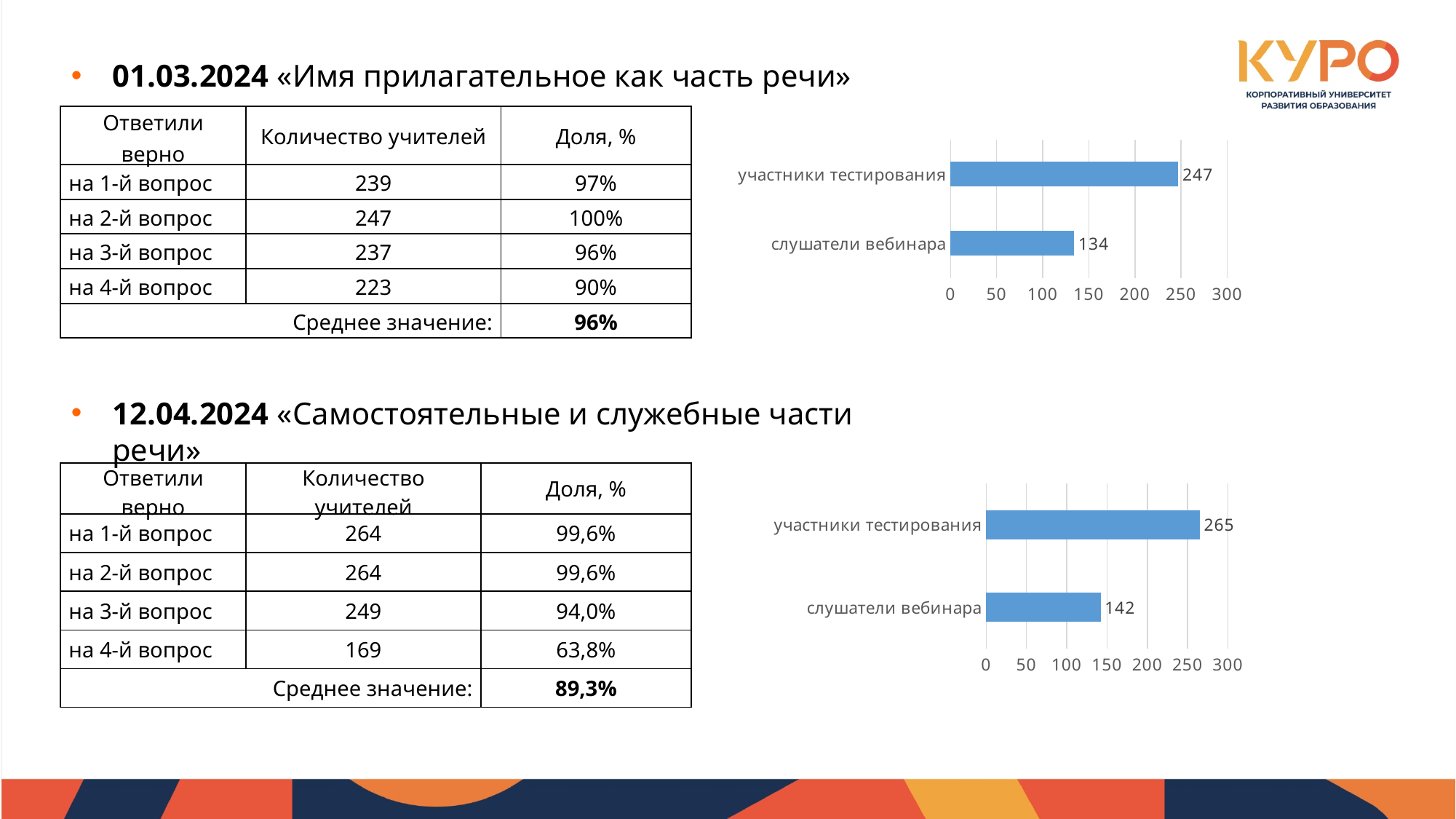
How many categories does the top chart (01.03.2024) show? 2 What type of chart is the bottom chart (12.04.2024)? bar chart In the bottom chart (12.04.2024), what is the difference between участники тестирования and слушатели вебинара? 123 In the top chart (01.03.2024), which category has the highest value? участники тестирования In the bottom chart (12.04.2024), which is larger: участники тестирования or слушатели вебинара? участники тестирования In the bottom chart (12.04.2024), what is the value for слушатели вебинара? 142 In the top chart (01.03.2024), is the value for слушатели вебинара greater or less than 150? less In the bottom chart (12.04.2024), which category has the lowest value? слушатели вебинара In the top chart (01.03.2024), what is the difference between участники тестирования and слушатели вебинара? 113 In the top chart (01.03.2024), what is the value for слушатели вебинара? 134 In the bottom chart (12.04.2024), what is the value for участники тестирования? 265 In the top chart (01.03.2024), what is the value for участники тестирования? 247